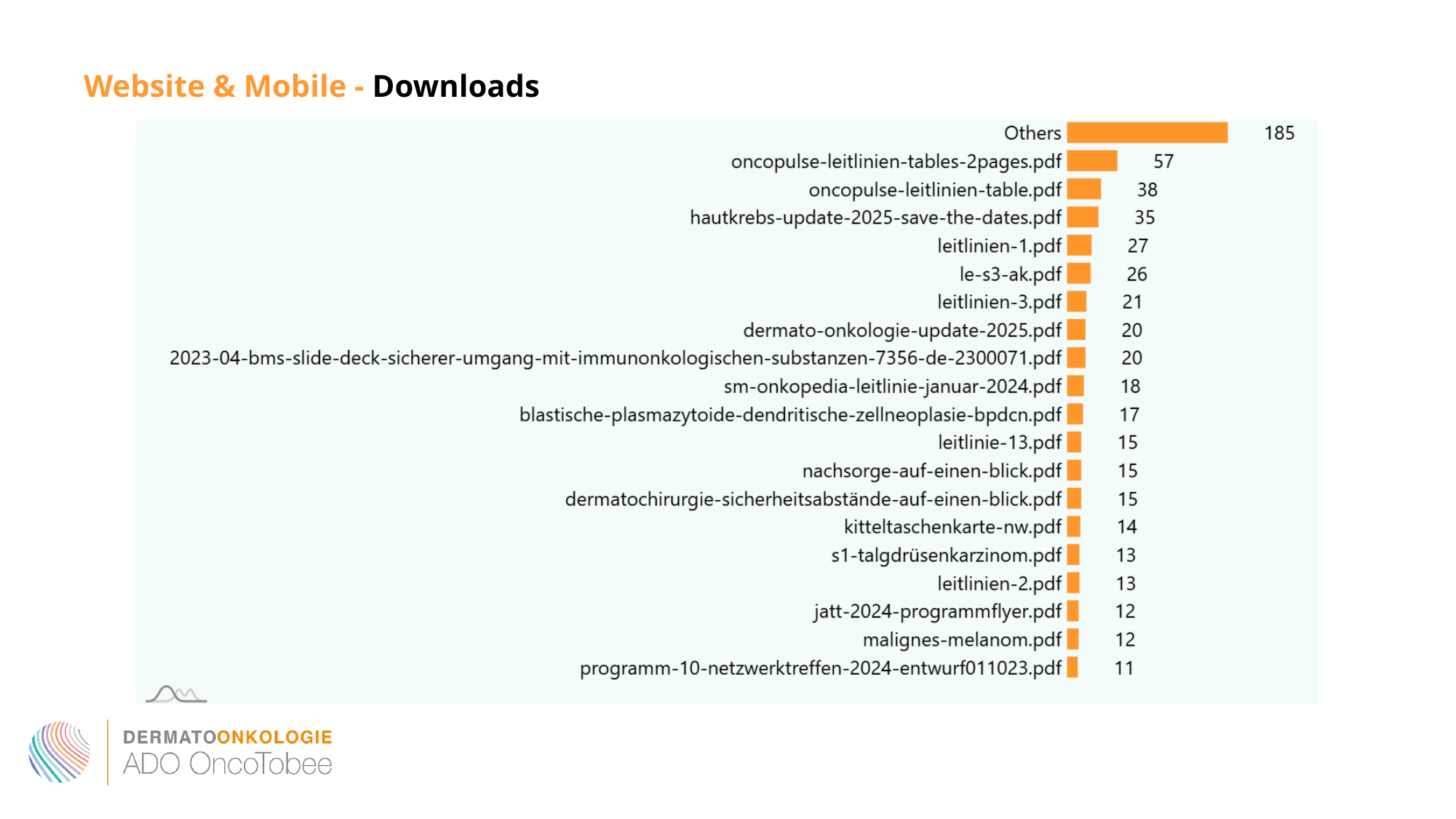
What is the difference between the values for Others and le-s3-ak.pdf? 159 How many downloads does the chart show for Others? 185 Which category has the highest value? Others Which category has the lowest value? programm-10-netzwerktreffen-2024-entwurf011023.pdf What type of chart is shown on the slide? bar chart What is the value for hautkrebs-update-2025-save-the-dates.pdf? 35 What is the value for oncopulse-leitlinien-tables-2pages.pdf? 57 Which has a larger value, leitlinien-1.pdf or leitlinien-3.pdf? leitlinien-1.pdf What is the value for kitteltaschenkarte-nw.pdf? 14 What is the title of the slide? Website & Mobile - Downloads How many categories are shown in the chart? 20 What is the difference between the values for oncopulse-leitlinien-tables-2pages.pdf and oncopulse-leitlinien-table.pdf? 19